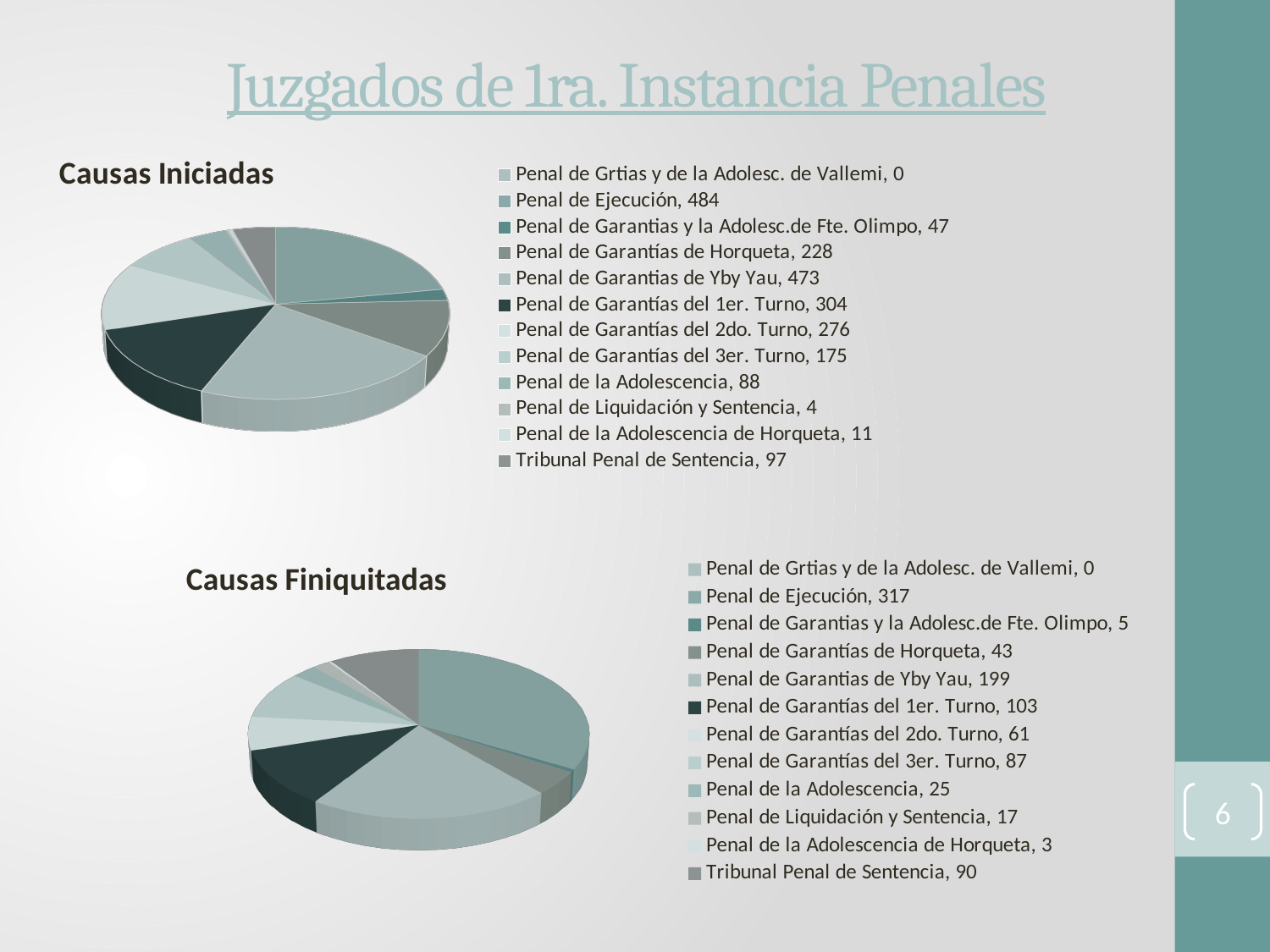
In the Causas Iniciadas chart, what is the difference between Penal de Ejecución and Penal de Garantias de Yby Yau? 11 In the Causas Finiquitadas chart, what is the value for Penal de Garantias de Yby Yau? 199 In the Causas Iniciadas chart, which category has the highest value? Penal de Ejecución In the Causas Finiquitadas chart, which is larger: Penal de Garantías del 2do. Turno or Penal de Garantías del 3er. Turno? Penal de Garantías del 3er. Turno In the Causas Finiquitadas chart, what is the value for Tribunal Penal de Sentencia? 90 In the Causas Iniciadas chart, what is the value for Penal de Garantías del 1er. Turno? 304 How many categories does the Causas Iniciadas chart have? 12 What is the title of the slide? Juzgados de 1ra. Instancia Penales In the Causas Finiquitadas chart, which category has the lowest value? Penal de Grtias y de la Adolesc. de Vallemi In the Causas Iniciadas chart, what is the value for Penal de Ejecución? 484 In the Causas Finiquitadas chart, what is the difference between Penal de Ejecución and Penal de Garantias de Yby Yau? 118 What kind of chart is the Causas Finiquitadas chart? Pie chart